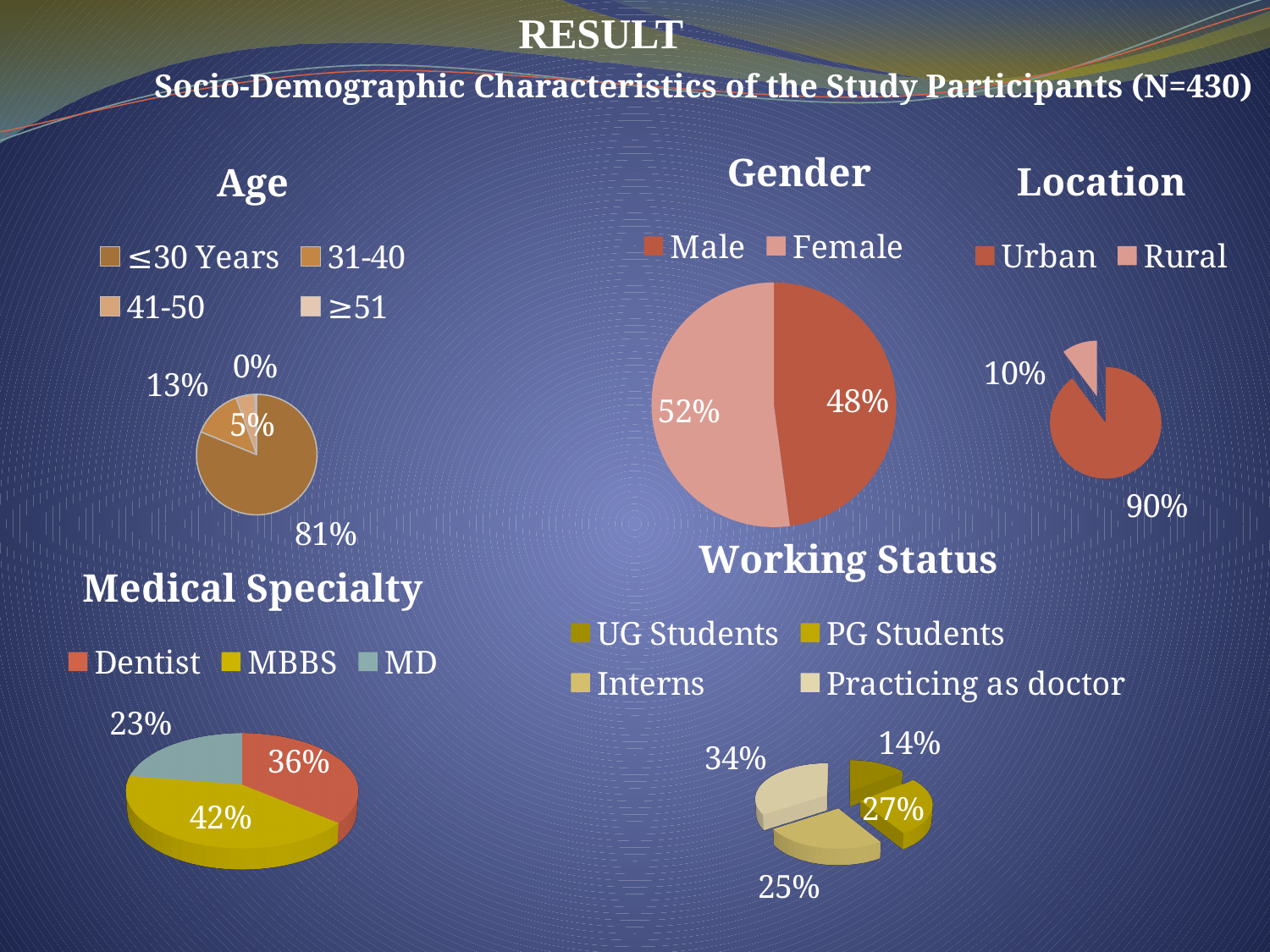
What type of chart is the Medical Specialty chart? Pie chart How many categories does the legend of the Working Status chart list? 4 In the Age chart, what percentage of participants are ≤30 Years? 81% How many charts are shown on the slide? 5 In the Medical Specialty chart, what percentage of participants are MBBS? 42% In the Working Status chart, what percentage of participants are Practicing as doctor? 34% In the Working Status chart, which category has the smallest share? UG Students In the Gender chart, what percentage of participants are Female? 52% In the Gender chart, what is the difference between the Female and Male percentages? 4% In the Location chart, which is larger, Urban or Rural? Urban In the Medical Specialty chart, which specialty has the largest share? MBBS In the Location chart, what percentage of participants are Urban? 90%